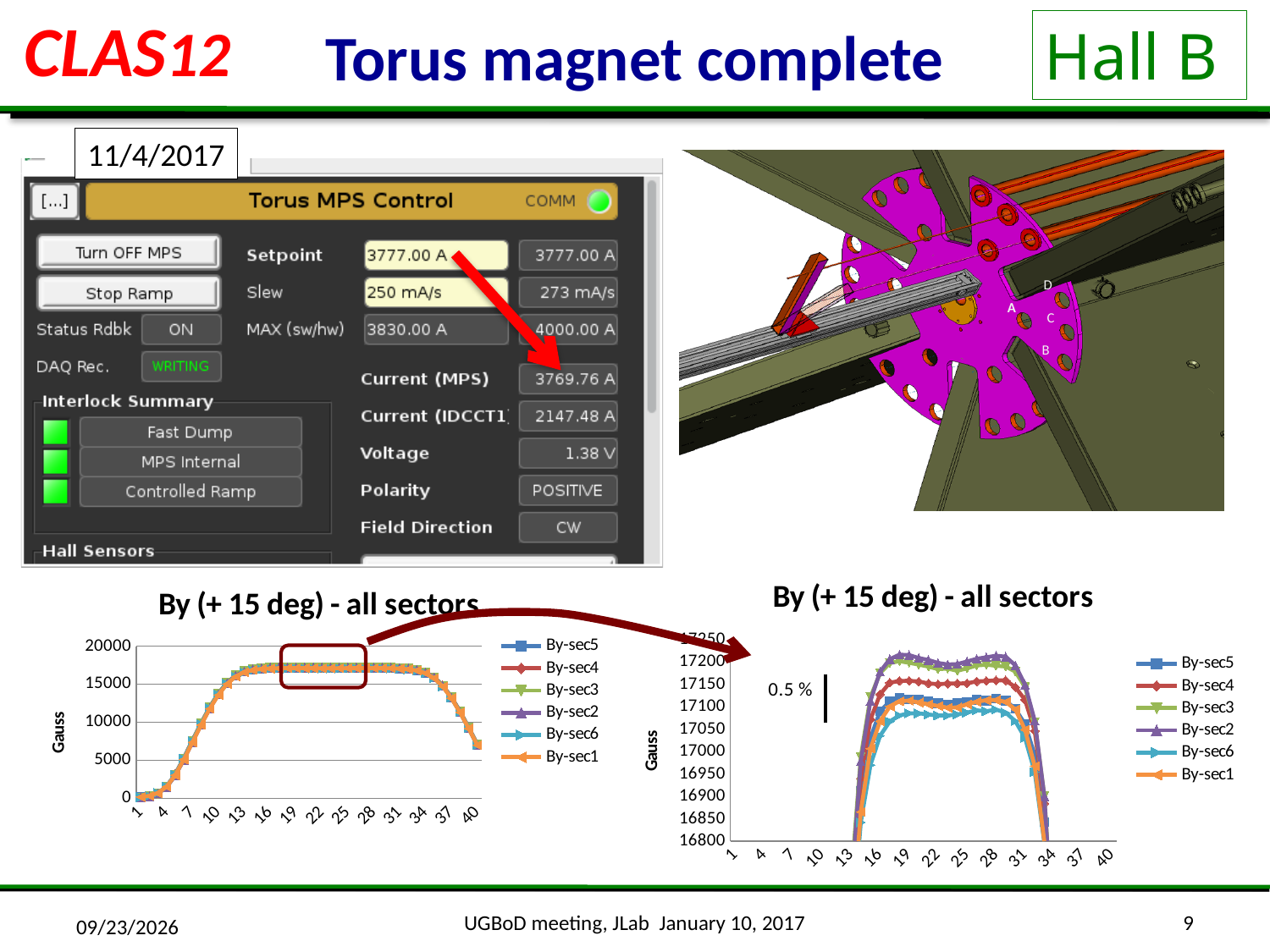
In the right (zoomed) chart, which series has the lowest values on the plateau around x = 19 to 28? By-sec6 In the right (zoomed) chart, which series has the highest values on the plateau around x = 19 to 28? By-sec2 How many series does the legend of the right (zoomed) chart list? 6 In the left chart, is the value of the series at x = 1 greater or less than 5000? less In the right (zoomed) chart, is the value of By-sec2 at x = 19 greater or less than 17150? greater What kind of chart is the left chart titled 'By (+ 15 deg) - all sectors'? line chart What is the y-axis label of the left chart? Gauss What is the title of the right chart? By (+ 15 deg) - all sectors In the left chart, do the values rise or fall between x = 1 and x = 13? rise In the left chart, do the values rise or fall between x = 31 and x = 40? fall In the left chart, is the plateau value of the series around x = 20 greater or less than 15000? greater How many series does the legend of the left chart list? 6